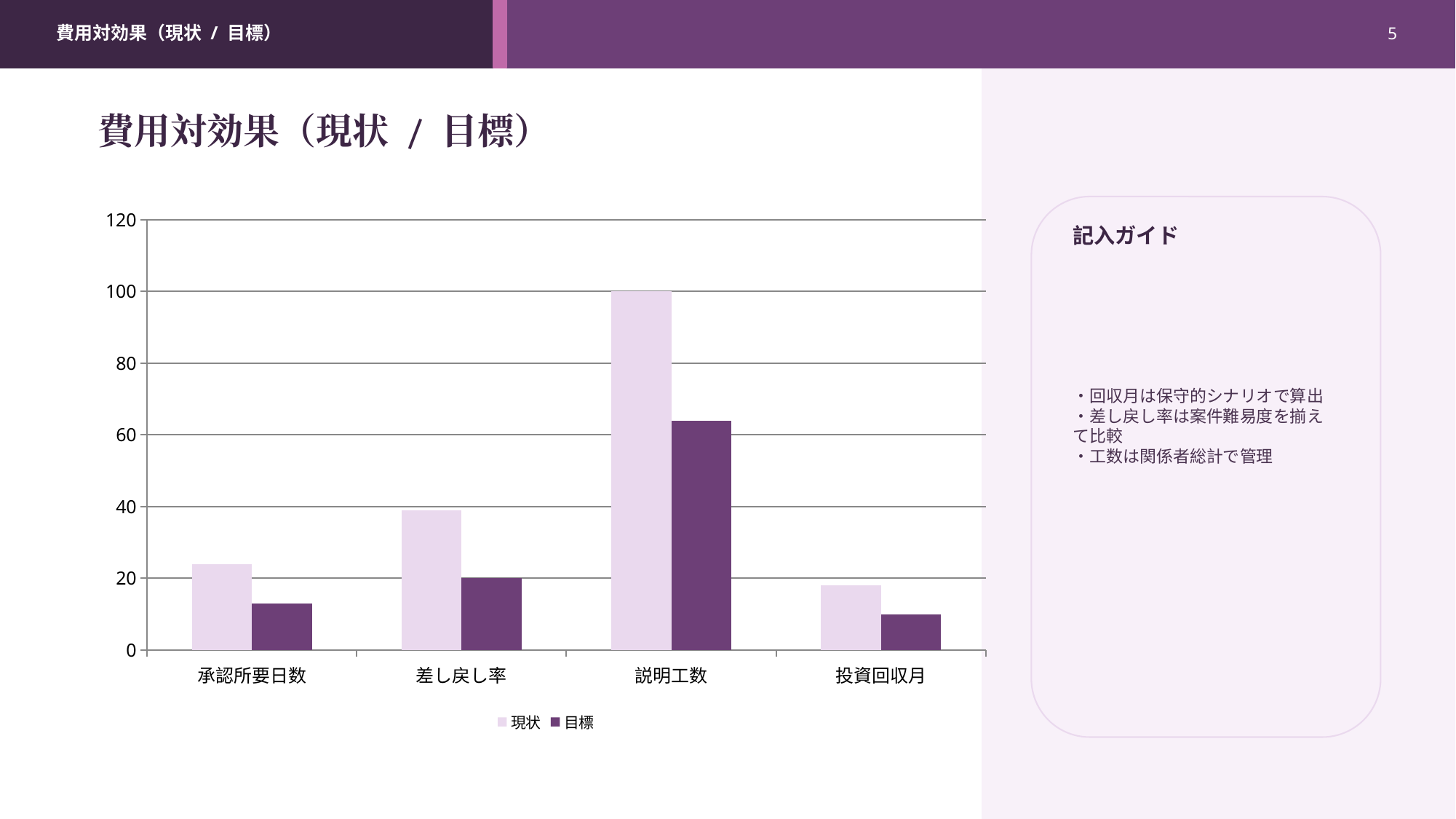
How many categories are shown on the x axis of the chart? 4 What are the two series named in the chart legend? 現状 and 目標 What is the 現状 value for 説明工数? 100 For 差し戻し率, which is larger: the 現状 value or the 目標 value? 現状 Is the 目標 value for 説明工数 greater or less than 80? less Is the 現状 value for 承認所要日数 greater or less than 20? greater Which category has the highest 現状 value? 説明工数 Which category has the highest 目標 value? 説明工数 What type of chart is shown on the slide? bar chart Which category has the lowest 現状 value? 投資回収月 How many series does the chart legend list? 2 What is the 目標 value for 差し戻し率? 20